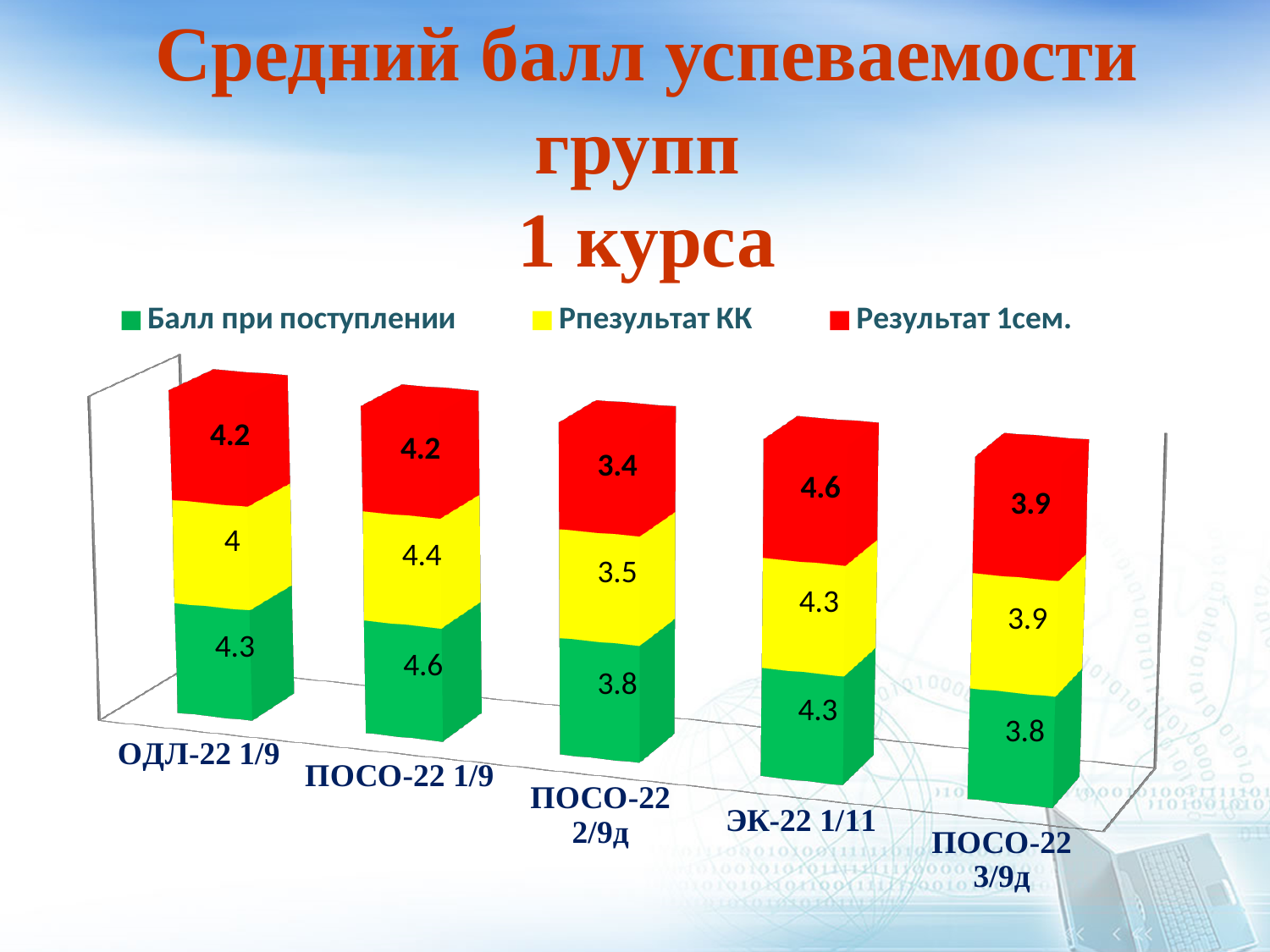
What kind of chart is shown on the slide? Stacked bar chart What is the value of Результат 1сем. for ПОСО-22 2/9д? 3.4 Which group has the lowest value for Рпезультат КК? ПОСО-22 2/9д What is the value of Балл при поступлении for ПОСО-22 1/9? 4.6 What is the total of the stacked bar for ПОСО-22 3/9д? 11.6 How many groups are shown on the chart? 5 What is the value of Рпезультат КК for ОДЛ-22 1/9? 4 How many series does the legend list? 3 Which group has the highest value for Результат 1сем.? ЭК-22 1/11 Which is larger for ПОСО-22 2/9д: Балл при поступлении or Рпезультат КК? Балл при поступлении What is the value of Результат 1сем. for ЭК-22 1/11? 4.6 What is the difference between Балл при поступлении and Результат 1сем. for ПОСО-22 1/9? 0.4